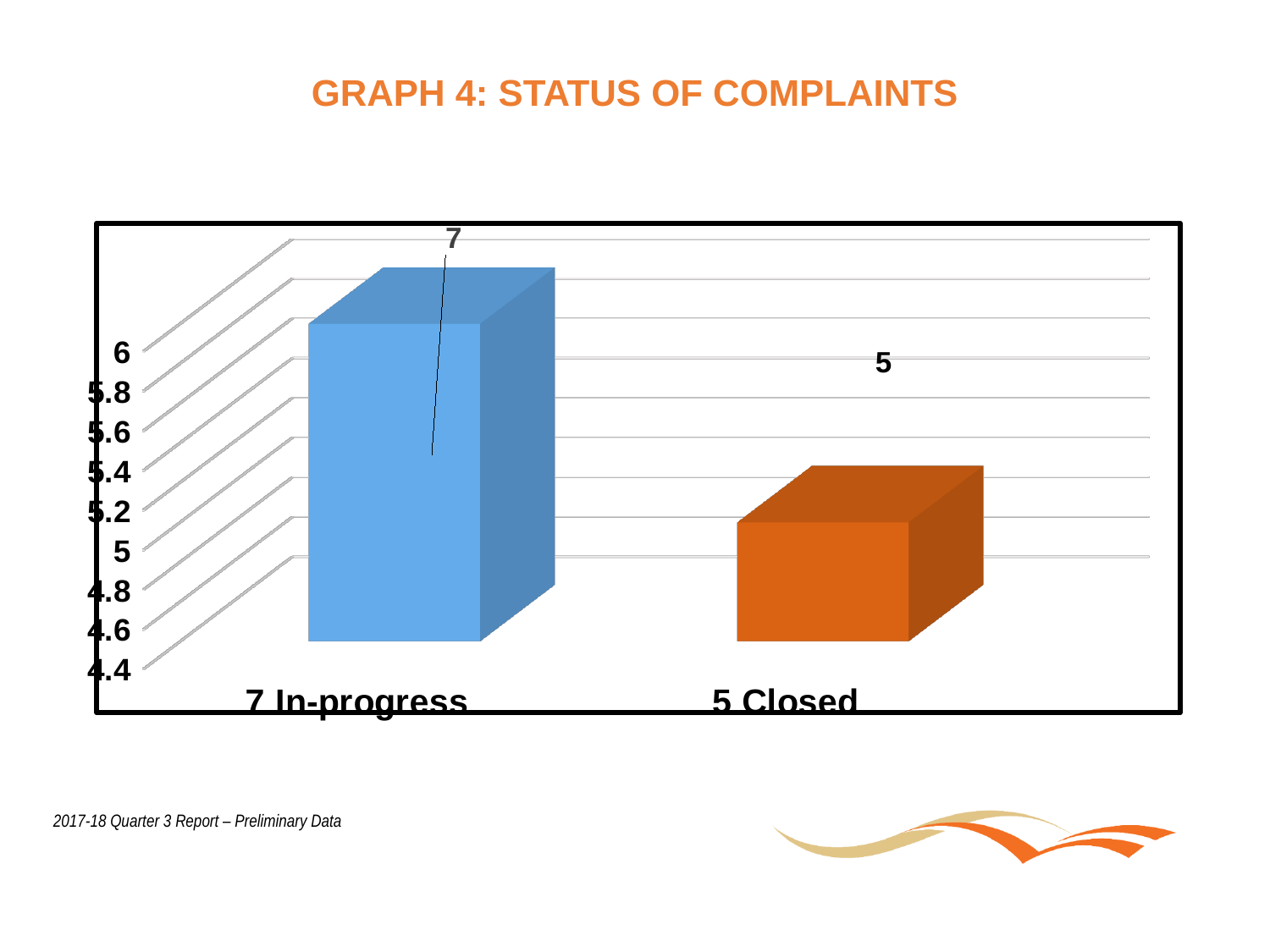
Is the value for Closed greater or less than 6? less Which is larger, the value for In-progress or the value for Closed? In-progress What colour is the bar for the Closed category? orange What is the title of the chart? GRAPH 4: STATUS OF COMPLAINTS What is the value for the Closed category? 5 What kind of chart is shown on the slide? bar chart Which category has the lowest value? 5 Closed How many categories are shown in the chart? 2 Is the value for In-progress greater or less than 6? greater What is the difference between the In-progress value and the Closed value? 2 What is the value for the In-progress category? 7 Which category has the highest value? 7 In-progress